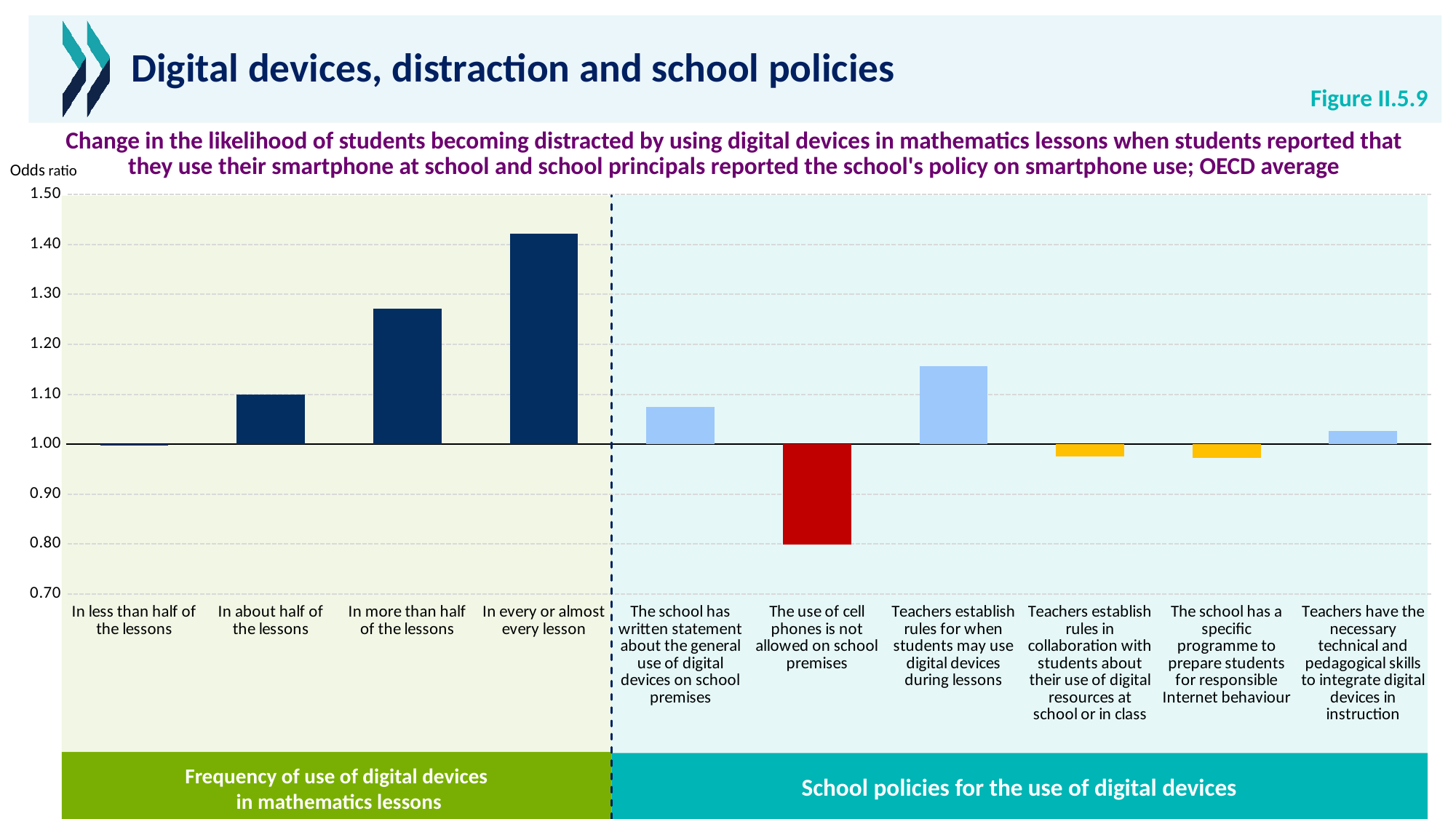
What kind of chart is shown on the slide? bar chart Is the odds ratio for "Teachers establish rules for when students may use digital devices during lessons" greater or less than 1.10? greater How many categories (bars) are plotted in the chart? 10 What is the title of the right-hand panel of the chart? School policies for the use of digital devices Is the odds ratio for "The use of cell phones is not allowed on school premises" greater or less than 0.90? less Which category has the highest odds ratio? In every or almost every lesson Which category has the lowest odds ratio? The use of cell phones is not allowed on school premises Which has a larger odds ratio: "In more than half of the lessons" or "In about half of the lessons"? In more than half of the lessons Is the odds ratio for "In every or almost every lesson" greater or less than 1.40? greater Do the odds ratios rise or fall across the four frequency-of-use categories from "In less than half of the lessons" to "In every or almost every lesson"? rise What is the label of the vertical axis? Odds ratio